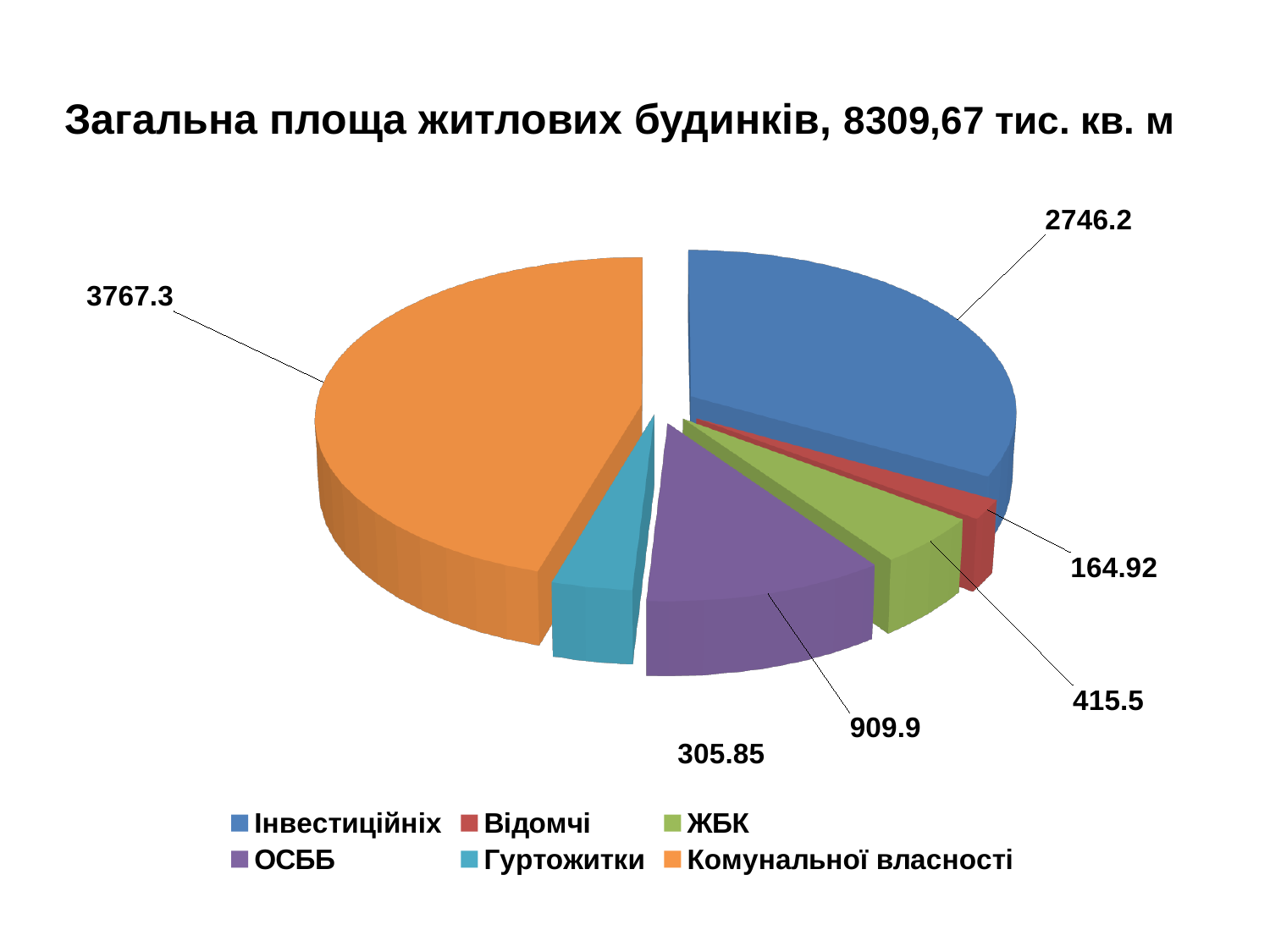
What kind of chart is shown on the slide? Pie chart How many categories does the pie chart show? 6 What is the value for Гуртожитки? 305.85 What is the value for Комунальної власності? 3767.3 Which category has the smallest slice? Відомчі Which category has the largest slice? Комунальної власності What is the value for ОСББ? 909.9 What is the value for Відомчі? 164.92 Which is larger, ОСББ or ЖБК? ОСББ What is the difference between the values for Комунальної власності and Інвестиційніх? 1021.1 What is the title of the chart? Загальна площа житлових будинків, 8309,67 тис. кв. м What is the value for Інвестиційніх? 2746.2